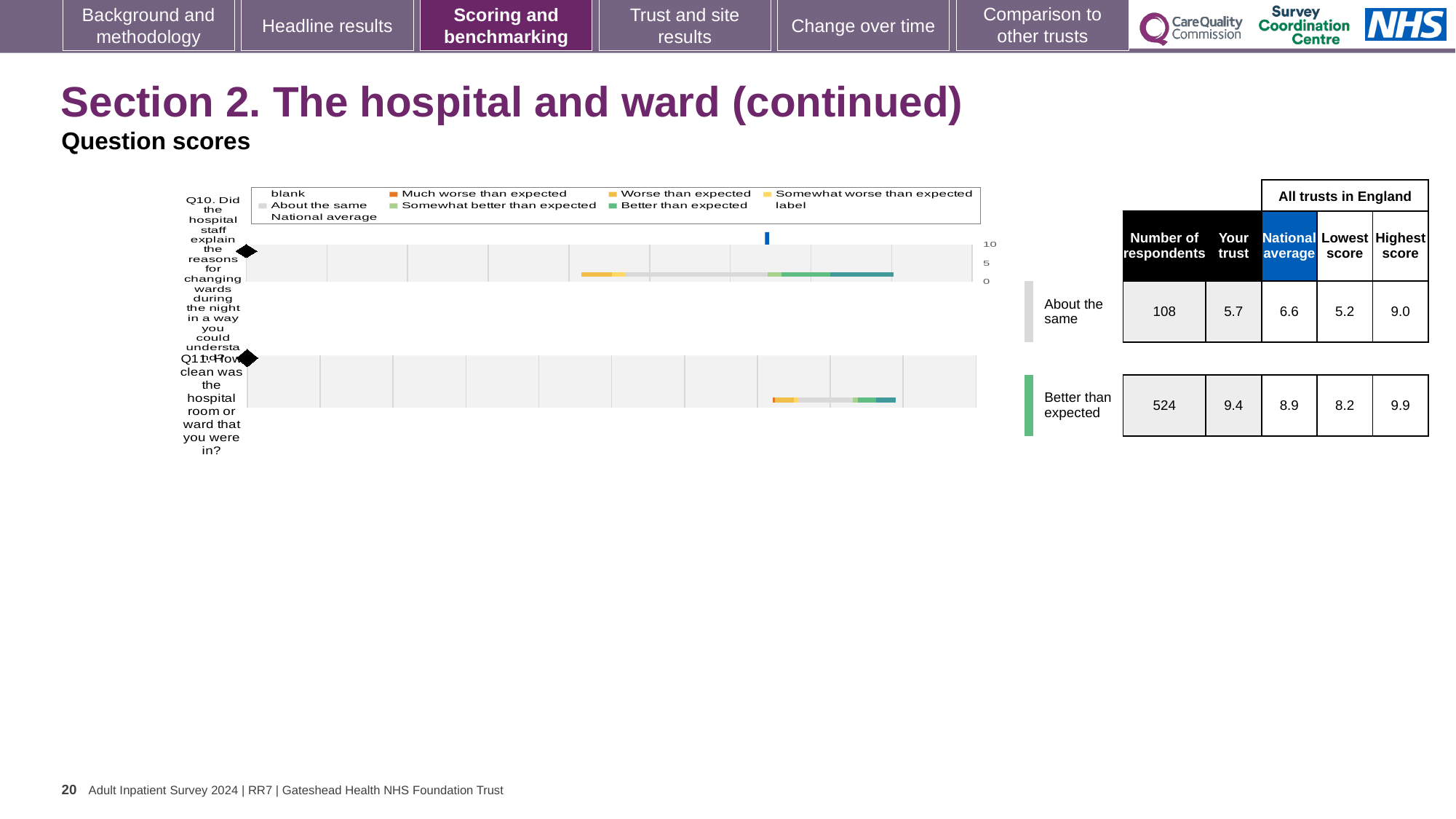
What is the highest score among all trusts in England for Q10? 9.0 For Q11, which is larger: the 'Your trust' score or the national average? Your trust How many questions are plotted in the chart? 2 How many respondents answered Q11, how clean was the hospital room or ward? 524 Which benchmark category is Q10 (explaining reasons for changing wards during the night) placed in? About the same What is the 'Your trust' score for Q11, how clean was the hospital room or ward? 9.4 Which benchmark category is Q11 (how clean was the hospital room or ward) placed in? Better than expected What is the difference between the highest score and the lowest score for Q11? 1.7 What is the difference between the national average and the 'Your trust' score for Q10? 0.9 What is the maximum value shown on the chart's score axis? 10 What kind of chart is used to show the question scores for Q10 and Q11? bar chart What is the national average score for Q10, explaining reasons for changing wards during the night? 6.6